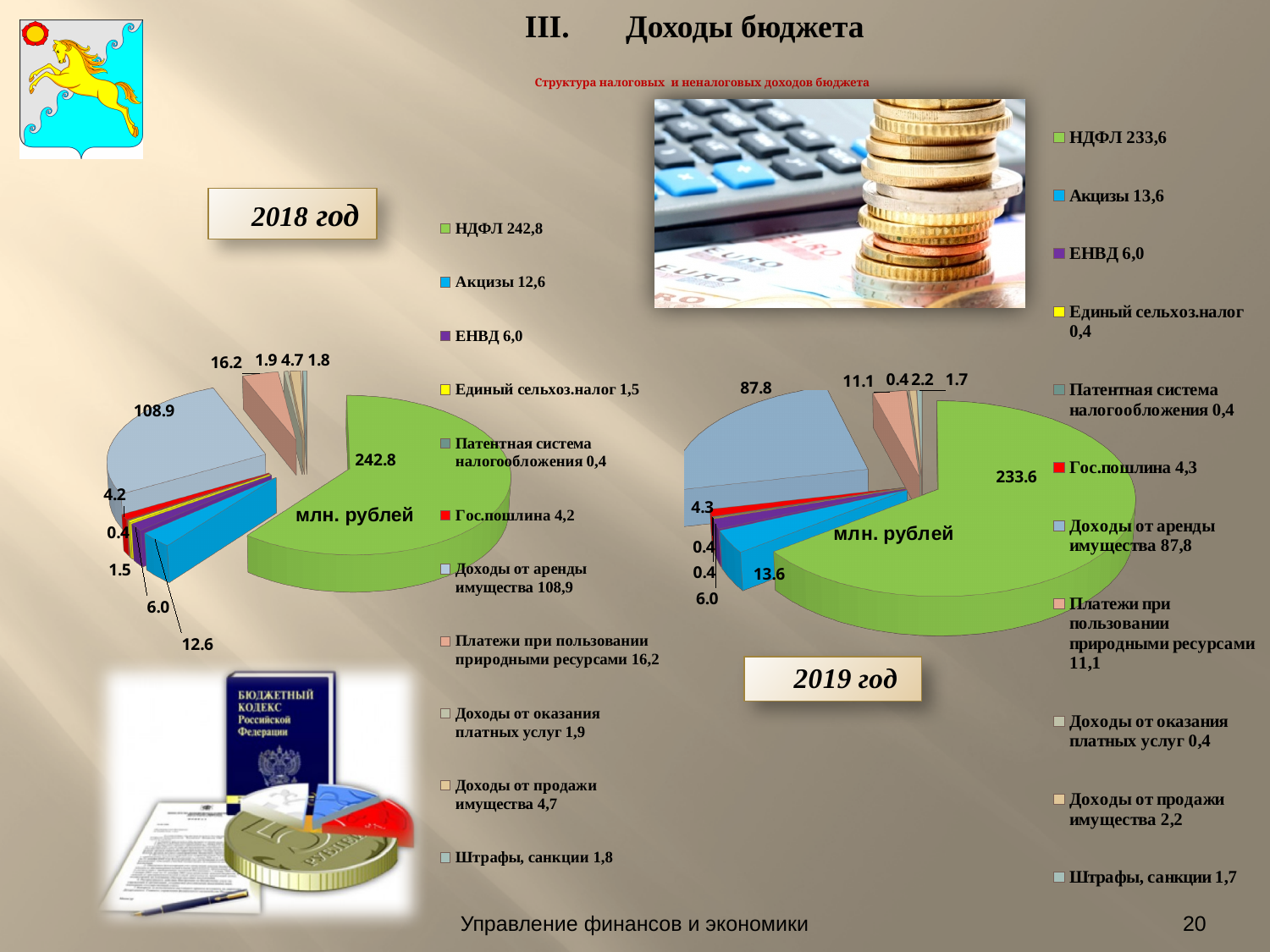
In the 2019 год chart, what is the difference between НДФЛ and Доходы от аренды имущества? 145.8 In the 2018 год chart, which category has the largest value? НДФЛ How many categories does the 2019 год chart show? 11 In the 2018 год chart, which is larger: Платежи при пользовании природными ресурсами or Акцизы? Платежи при пользовании природными ресурсами In the 2019 год chart, what is the value for Доходы от аренды имущества? 87.8 What kind of chart is used for the 2018 год chart on the left? pie chart In the 2018 год chart, which category has the smallest value? Патентная система налогообложения In the 2018 год chart, what is the difference between НДФЛ and Доходы от аренды имущества? 133.9 In the 2019 год chart, which category has the largest value? НДФЛ In the 2019 год chart, what is the value for Гос.пошлина? 4.3 What unit label is printed in the centre of both pie charts? млн. рублей In the 2018 год chart, what is the value for НДФЛ? 242.8